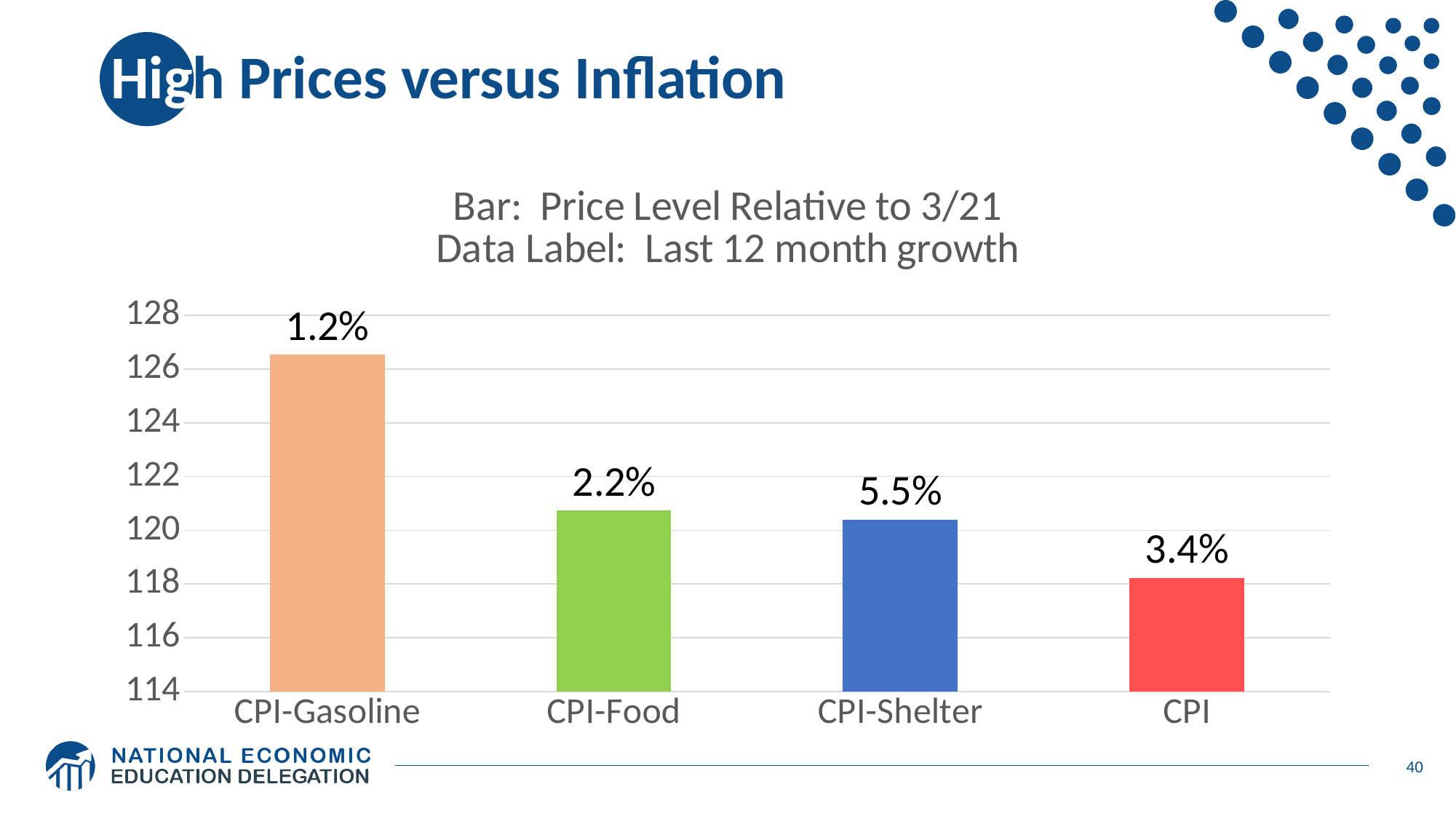
What is the data label shown above the CPI-Food bar? 2.2% What is the data label shown above the CPI-Shelter bar? 5.5% Which category has the tallest bar (highest price level relative to 3/21)? CPI-Gasoline Which category has the shortest bar (lowest price level relative to 3/21)? CPI What type of chart is shown on the slide? Bar chart Which bar is taller, CPI-Gasoline or CPI-Food? CPI-Gasoline Is the bar for CPI-Gasoline greater or less than 124? greater Which category has the largest last-12-month growth data label? CPI-Shelter What is the data label shown above the CPI-Gasoline bar? 1.2% What is the data label shown above the CPI bar? 3.4% Is the bar for CPI greater or less than 120? less How many categories are shown on the x axis? 4